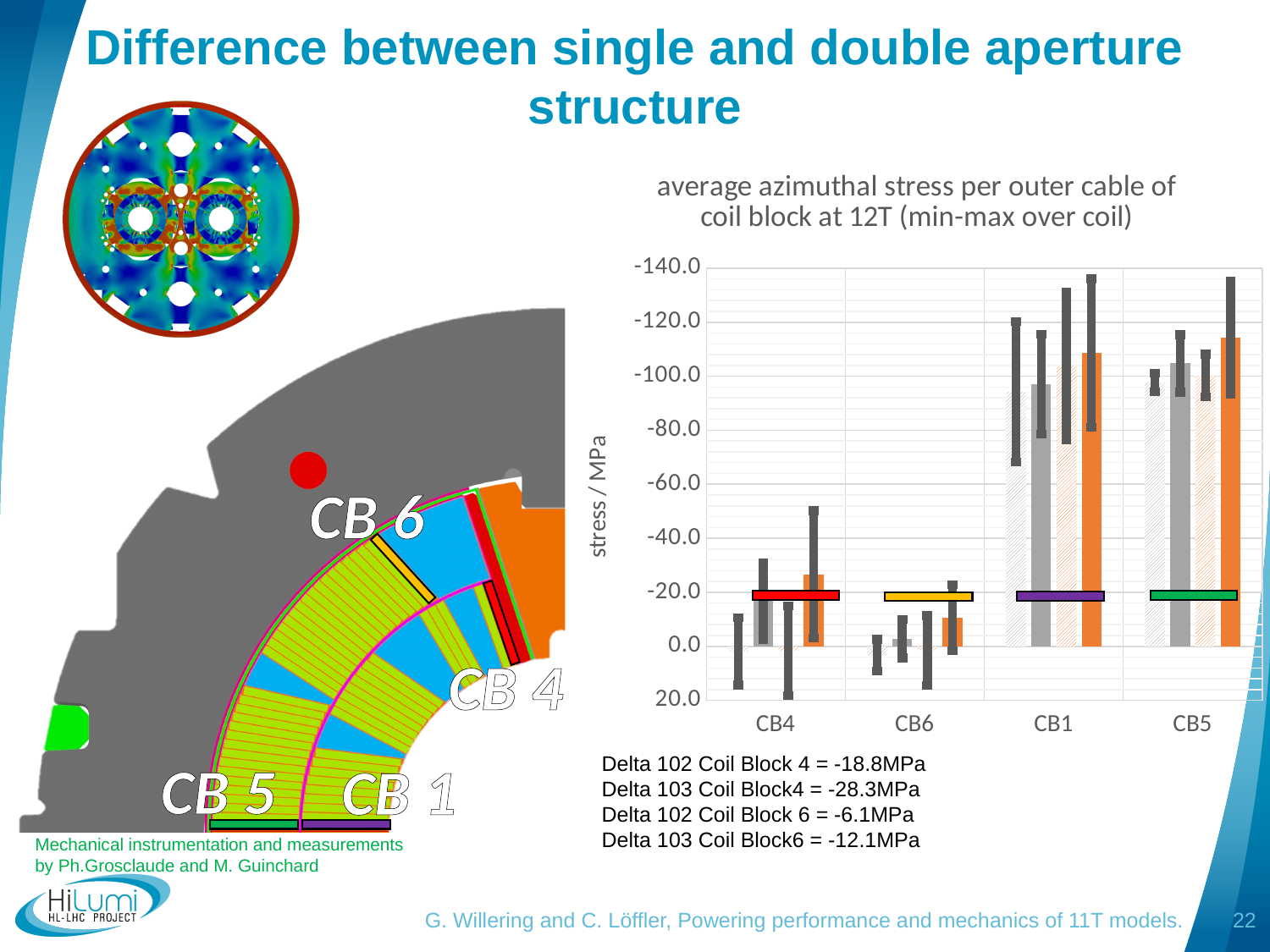
Which categories are listed on the x axis of the chart, from left to right? CB4, CB6, CB1, CB5 Which coil block category shows the smallest magnitude of azimuthal stress in the chart? CB6 Is the value of the solid orange bar for CB1 numerically greater or less than -100.0 on the stress axis? less Which category shows a larger magnitude of stress in the chart, CB4 or CB6? CB4 What is the label of the vertical axis of the chart? stress / MPa What is the lowest tick value shown at the top of the stress axis in the chart? -140.0 What is the title of the chart? average azimuthal stress per outer cable of coil block at 12T (min-max over coil) How many bars are plotted for each coil block category in the chart? 4 Is the value of the solid orange bar for CB6 numerically greater or less than -20.0 on the stress axis? greater Which category shows a larger magnitude of stress in the chart, CB1 or CB4? CB1 What type of chart is shown on the slide? bar chart How many coil block categories are shown on the x axis of the chart? 4